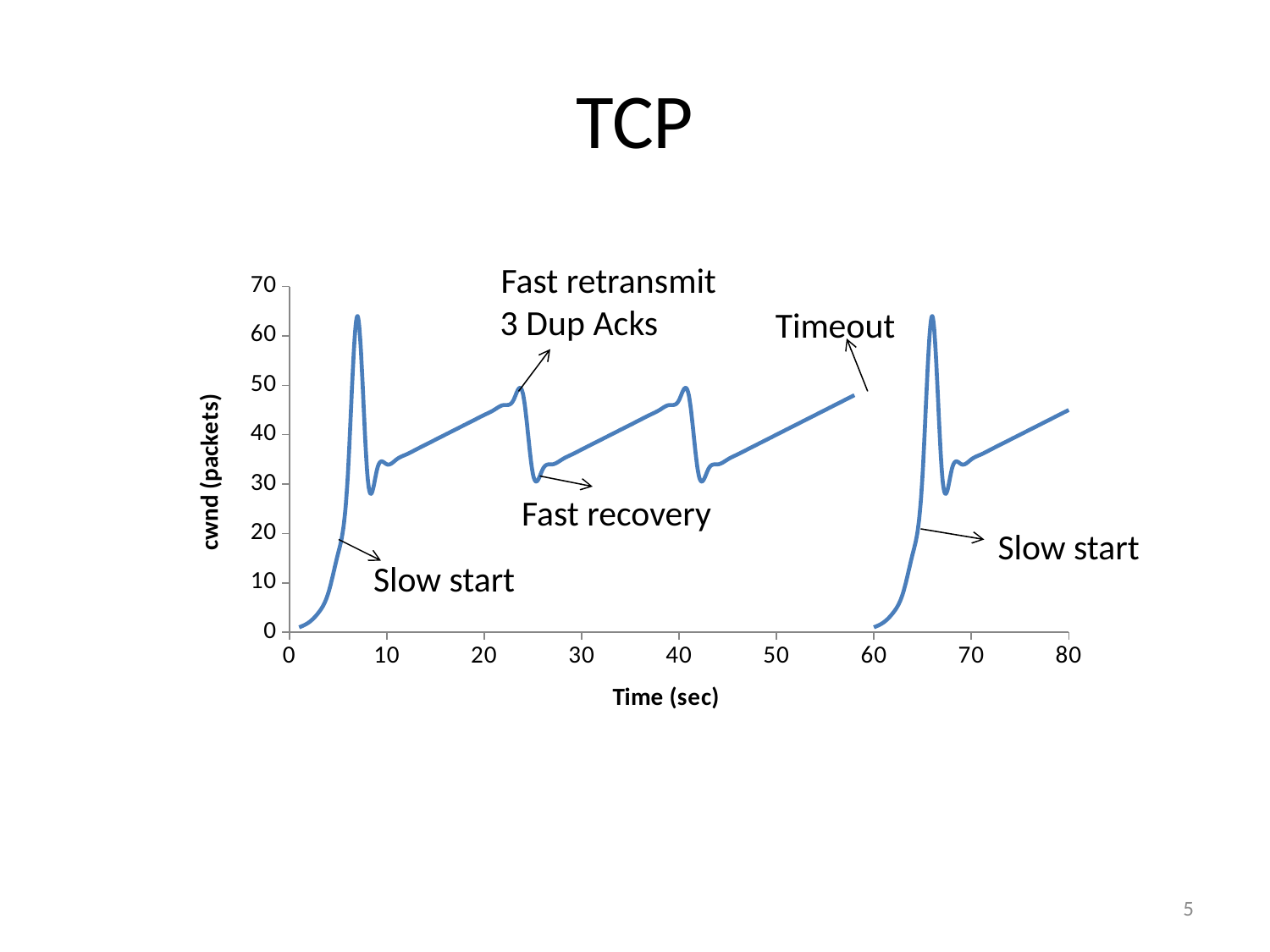
What is the label of the vertical axis of the chart? cwnd (packets) Is the value of cwnd at time 80 sec greater or less than 40? greater Does cwnd rise or fall between time 10 sec and time 22 sec? rise What kind of chart is shown on the slide? line chart What is the highest value shown on the vertical axis of the chart? 70 Is the value of cwnd at time 70 sec greater or less than 40? less What is the title of the slide containing the chart? TCP Does cwnd rise or fall between time 45 sec and time 58 sec? rise Is the value of cwnd at time 5 sec greater or less than 20? less Which is larger, the cwnd peak near time 7 sec or the cwnd peak near time 24 sec? the peak near time 7 sec